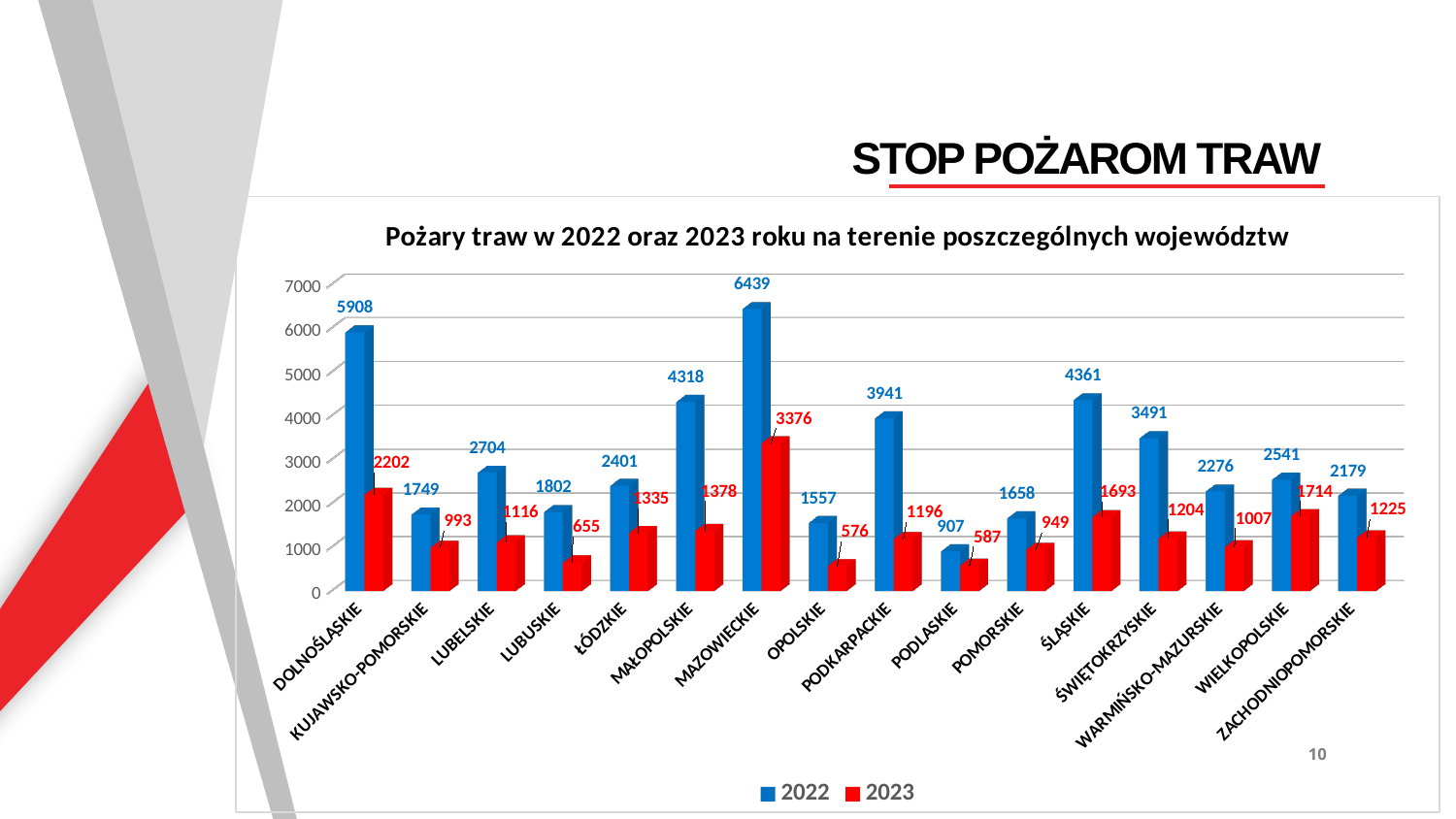
How many series does the legend list? 2 What is the title of the chart? Pożary traw w 2022 oraz 2023 roku na terenie poszczególnych województw What is the difference between the 2022 and 2023 values for DOLNOŚLĄSKIE? 3706 Which category has the lowest value in the 2023 series? OPOLSKIE What kind of chart is shown on the slide? Bar chart What is the value for ŚLĄSKIE in the 2023 series? 1693 Which is larger: the 2022 value for MAŁOPOLSKIE or the 2022 value for ŚLĄSKIE? ŚLĄSKIE What is the value for MAZOWIECKIE in the 2022 series? 6439 Which category has the highest value in the 2023 series? MAZOWIECKIE Which category has the lowest value in the 2022 series? PODLASKIE How many categories (voivodeships) are shown on the x axis? 16 What is the value for PODLASKIE in the 2022 series? 907